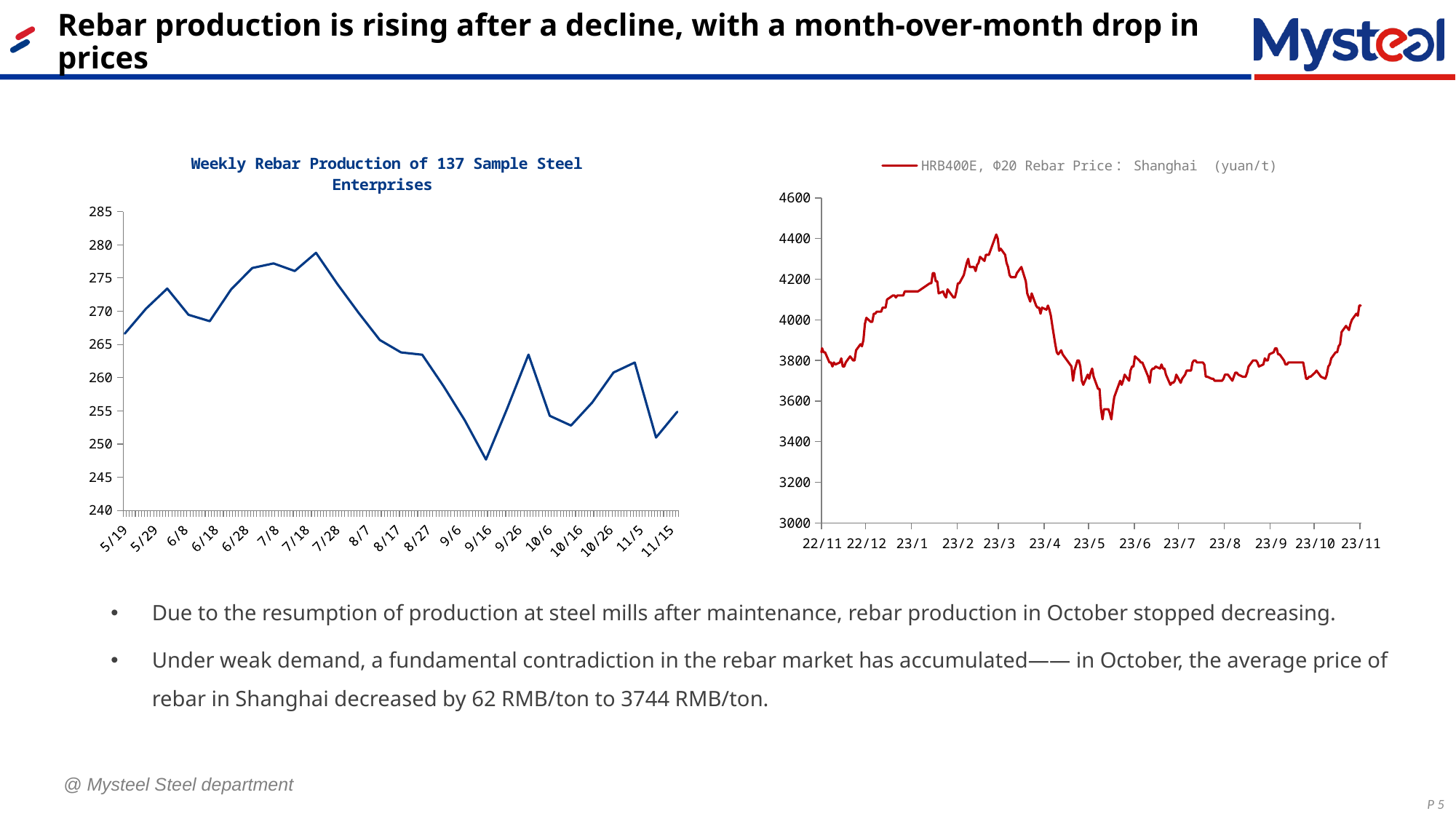
In the right-hand chart of the HRB400E Φ20 rebar price in Shanghai, is the lowest point of the line greater or less than 3600? less In the 'Weekly Rebar Production of 137 Sample Steel Enterprises' chart, around which date does production reach its lowest point? 9/16 In the right-hand chart of the HRB400E Φ20 rebar price in Shanghai, around which month does the price reach its highest point? 23/3 In the 'Weekly Rebar Production of 137 Sample Steel Enterprises' chart, is the value at 11/15 greater or less than 260? less How many series does the legend of the right-hand rebar price chart list? 1 In the right-hand chart of the HRB400E Φ20 rebar price in Shanghai, is the value at 23/11 greater or less than 4000? greater What kind of chart is the 'Weekly Rebar Production of 137 Sample Steel Enterprises' chart? line chart What kind of chart is the right-hand chart showing the HRB400E Φ20 rebar price in Shanghai? line chart In the right-hand chart of the HRB400E Φ20 rebar price in Shanghai, does the price rise or fall between 23/3 and 23/5? fall In the 'Weekly Rebar Production of 137 Sample Steel Enterprises' chart, does production rise or fall between 7/28 and 9/16? fall